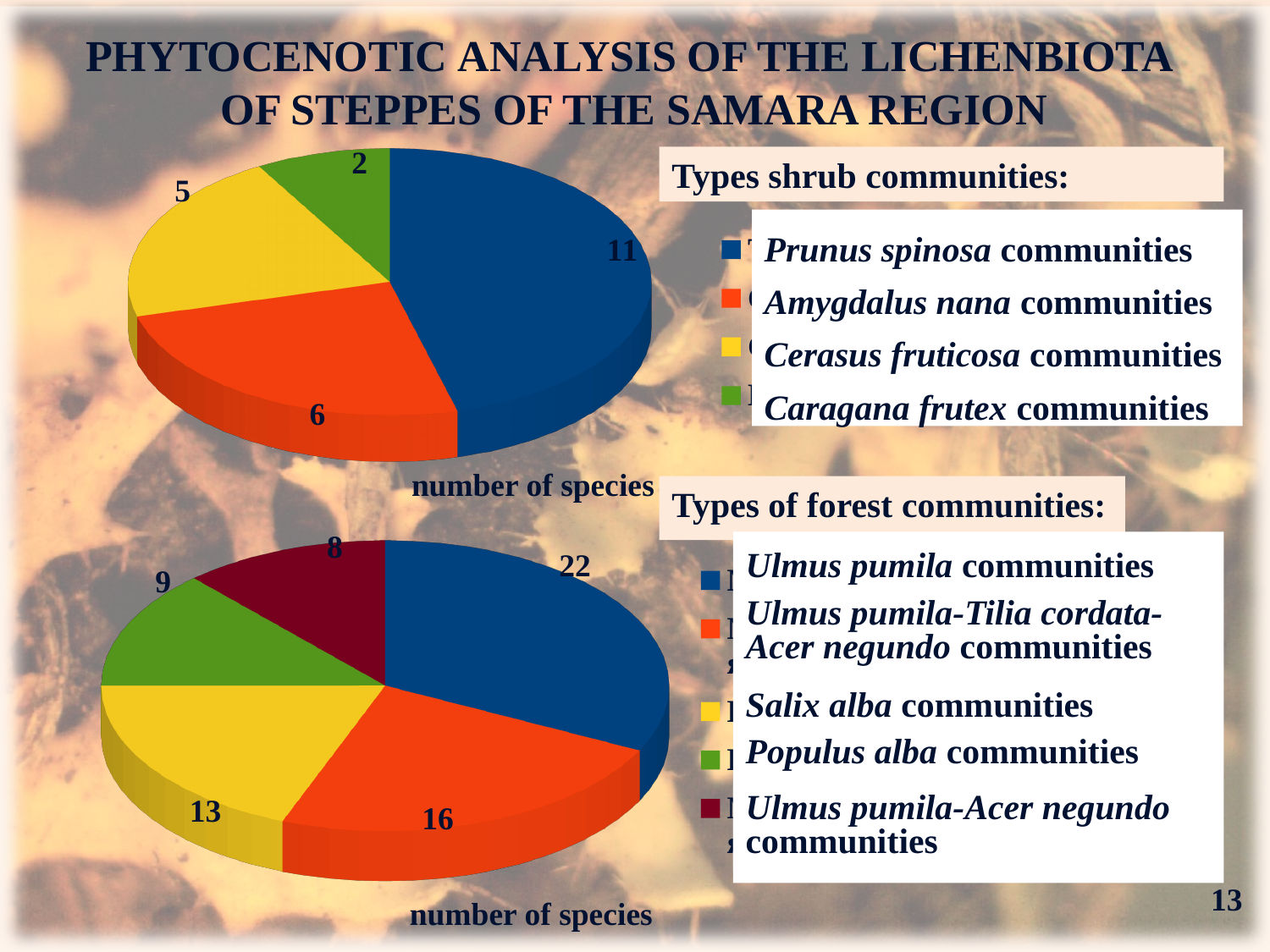
In the bottom pie chart (forest communities), what colour is the slice for Ulmus pumila-Acer negundo communities? dark red In the bottom pie chart (forest communities), which community type has the highest number of species? Ulmus pumila communities In the top pie chart (shrub communities), which community type has the lowest number of species? Caragana frutex communities In the top pie chart (shrub communities), what is the number of species for Caragana frutex communities? 2 In the top pie chart (shrub communities), what is the number of species for Prunus spinosa communities? 11 How many slices does the bottom pie chart (forest communities) have? 5 How many slices does the top pie chart (shrub communities) have? 4 In the bottom pie chart (forest communities), what is the number of species for Salix alba communities? 13 In the top pie chart (shrub communities), what is the difference in number of species between Prunus spinosa communities and Amygdalus nana communities? 5 What kind of chart is the top chart on the slide (shrub communities)? pie chart In the bottom pie chart (forest communities), what is the total number of species across all five slices? 68 In the bottom pie chart (forest communities), which has more species: Populus alba communities or Ulmus pumila-Acer negundo communities? Populus alba communities